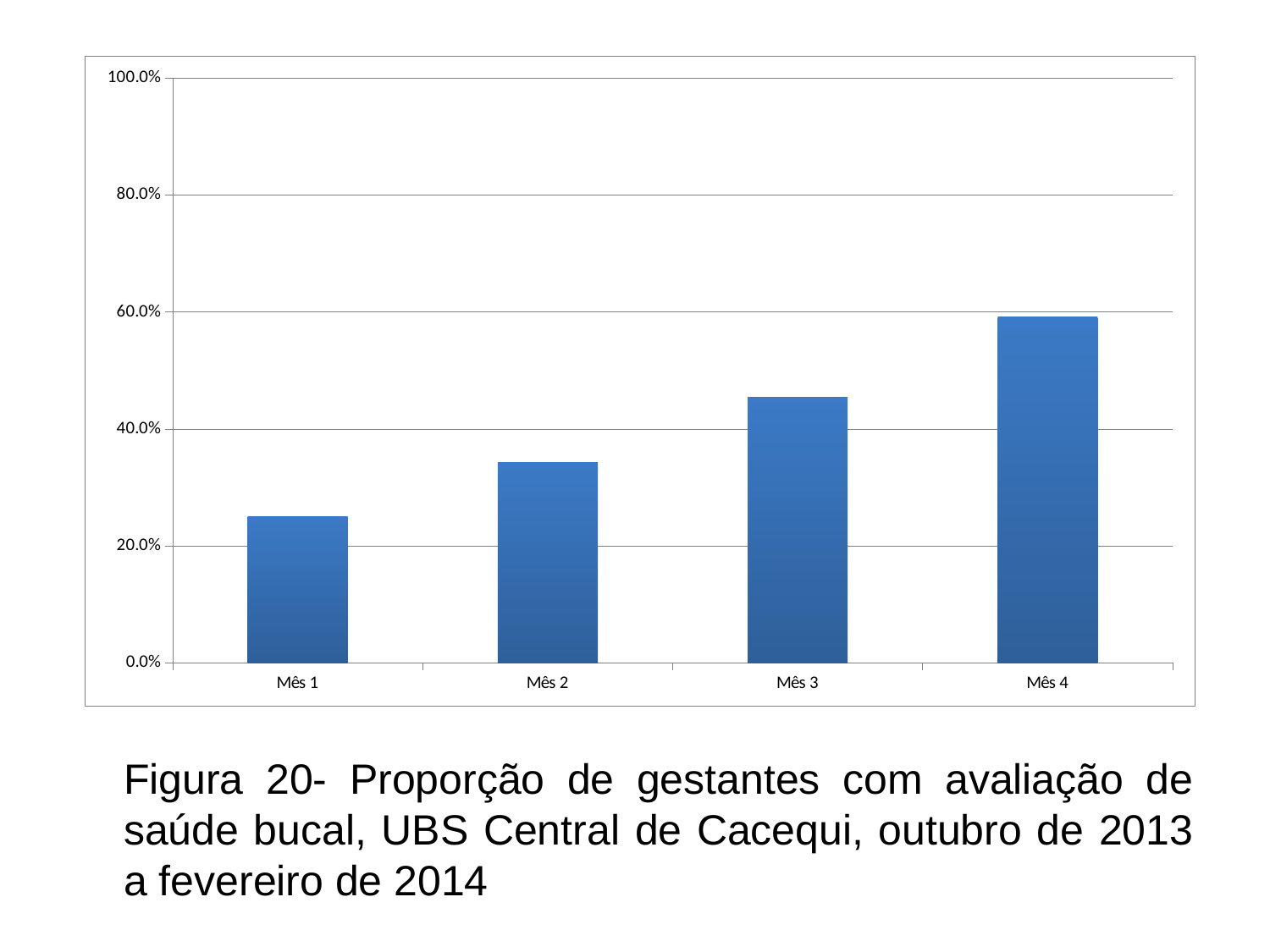
Is the value for Mês 3 greater or less than 40.0%? greater Do the values rise or fall from Mês 1 to Mês 4? rise According to the caption, which health unit does the chart refer to? UBS Central de Cacequi Which is larger, the value for Mês 2 or the value for Mês 3? Mês 3 Is the value for Mês 2 greater or less than 40.0%? less Which month has the highest proportion of pregnant women with oral health evaluation? Mês 4 What kind of chart is shown on the slide? bar chart Is the value for Mês 4 greater or less than 40.0%? greater What is the maximum value shown on the vertical axis? 100.0% How many categories (months) are plotted on the chart? 4 Which month has the lowest value on the chart? Mês 1